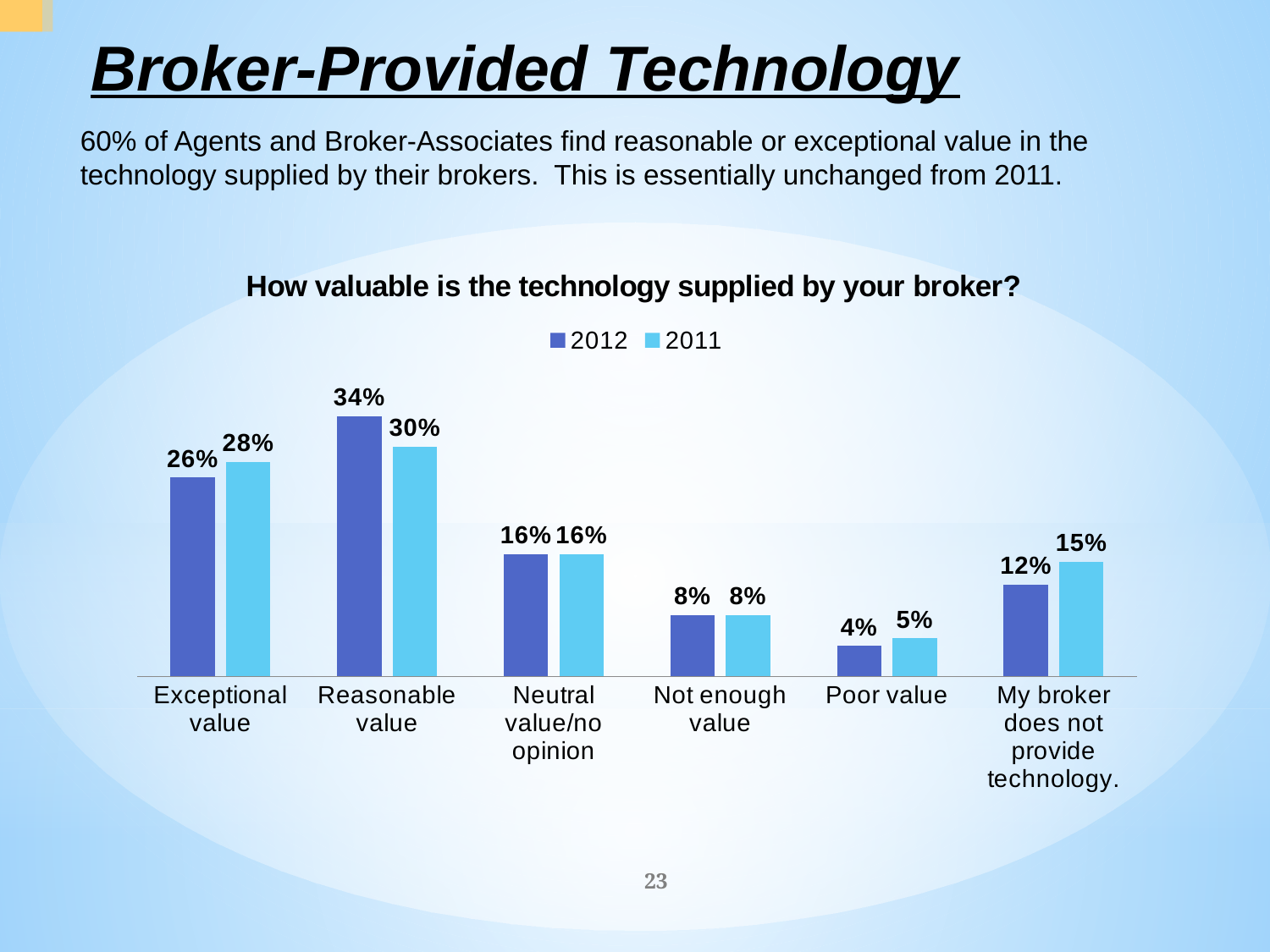
What is the title of the chart? How valuable is the technology supplied by your broker? What is the 2011 value for My broker does not provide technology? 15% How many series does the legend list? 2 Which is larger for Reasonable value, the 2012 value or the 2011 value? 2012 How many categories are shown on the x axis? 6 What is the 2012 value for Poor value? 4% Which category has the highest 2012 value? Reasonable value Which category has the lowest 2011 value? Poor value What kind of chart is shown on the slide? Bar chart What is the 2012 value for Reasonable value? 34% What is the difference between the 2012 values for Reasonable value and Neutral value/no opinion? 18% What is the difference between the 2012 and 2011 values for Exceptional value? 2%